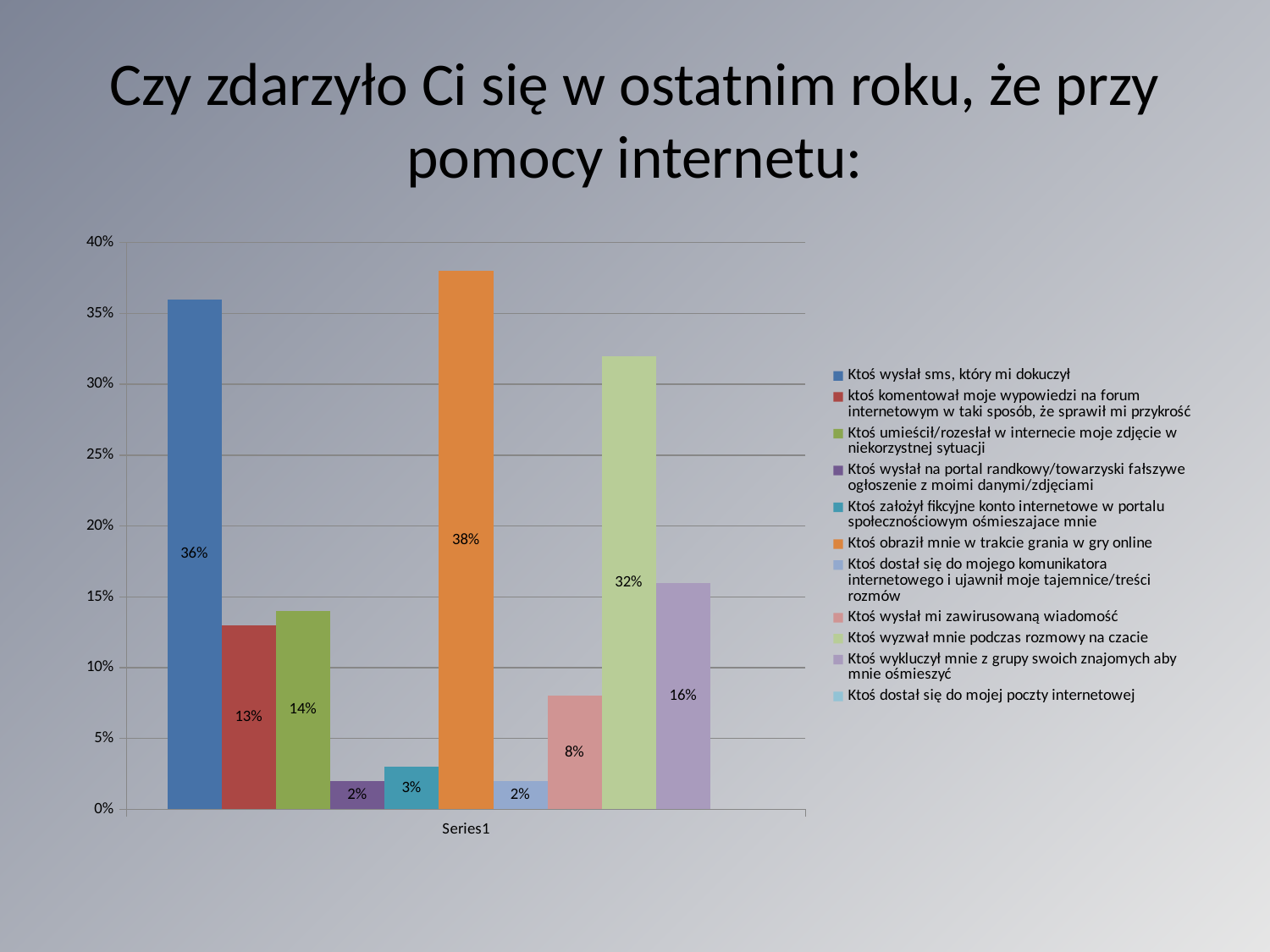
What is the value for "Ktoś obraził mnie w trakcie grania w gry online"? 38% What is the value for "Ktoś wyzwał mnie podczas rozmowy na czacie"? 32% Which is larger: the value for "Ktoś umieścił/rozesłał w internecie moje zdjęcie w niekorzystnej sytuacji" or for "Ktoś wykluczył mnie z grupy swoich znajomych aby mnie ośmieszyć"? Ktoś wykluczył mnie z grupy swoich znajomych aby mnie ośmieszyć What is the value for "Ktoś wysłał mi zawirusowaną wiadomość"? 8% What is the value for "Ktoś wykluczył mnie z grupy swoich znajomych aby mnie ośmieszyć"? 16% What is the difference between the values for "Ktoś obraził mnie w trakcie grania w gry online" and "Ktoś wysłał sms, który mi dokuczył"? 2% What is the value for "Ktoś wysłał sms, który mi dokuczył"? 36% What is the title of the slide? Czy zdarzyło Ci się w ostatnim roku, że przy pomocy internetu: How many entries does the legend list? 11 How many bars are plotted in the chart? 10 Which category has the highest value? Ktoś obraził mnie w trakcie grania w gry online What type of chart is shown on the slide? bar chart